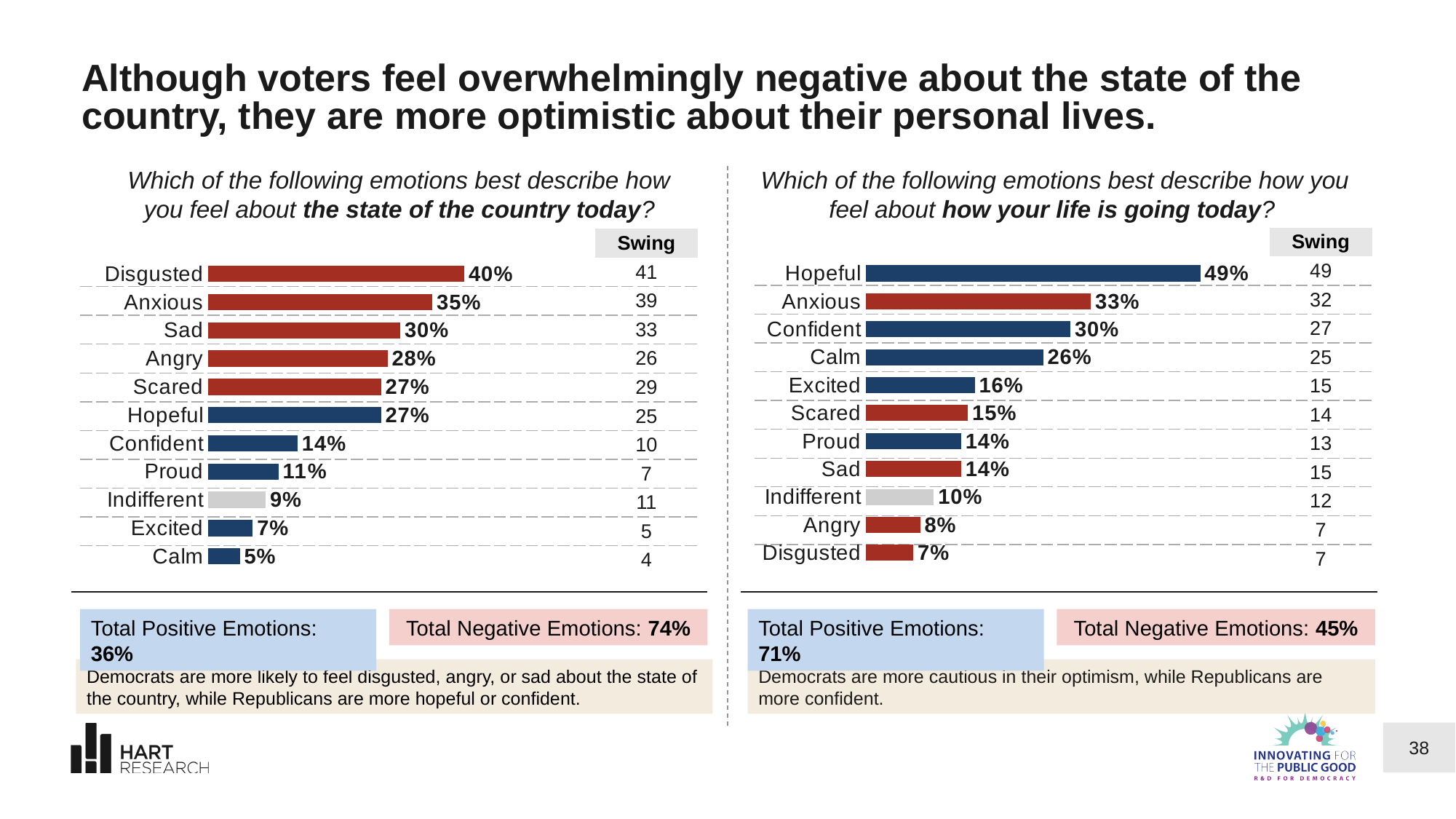
In the right chart about how your life is going today, what is the difference between the percentages for Hopeful and Anxious? 16% How many emotions are listed in the left chart about the state of the country today? 11 In the right chart about how your life is going today, what is the Total Negative Emotions percentage shown below the chart? 45% In the right chart about how your life is going today, which is larger: the percentage for Calm or the percentage for Excited? Calm In the left chart about the state of the country today, what is the Swing value for Anxious? 39 What kind of chart is used on the right side about how your life is going today? Bar chart In the right chart about how your life is going today, which emotion has the highest percentage? Hopeful In the left chart about the state of the country today, what percentage of voters feel Disgusted? 40% In the right chart about how your life is going today, what percentage of voters feel Hopeful? 49% In the left chart about the state of the country today, what is the difference between the percentages for Disgusted and Anxious? 5% In the left chart about the state of the country today, which emotion has the lowest percentage? Calm In the left chart about the state of the country today, which is larger: the percentage for Sad or the percentage for Confident? Sad